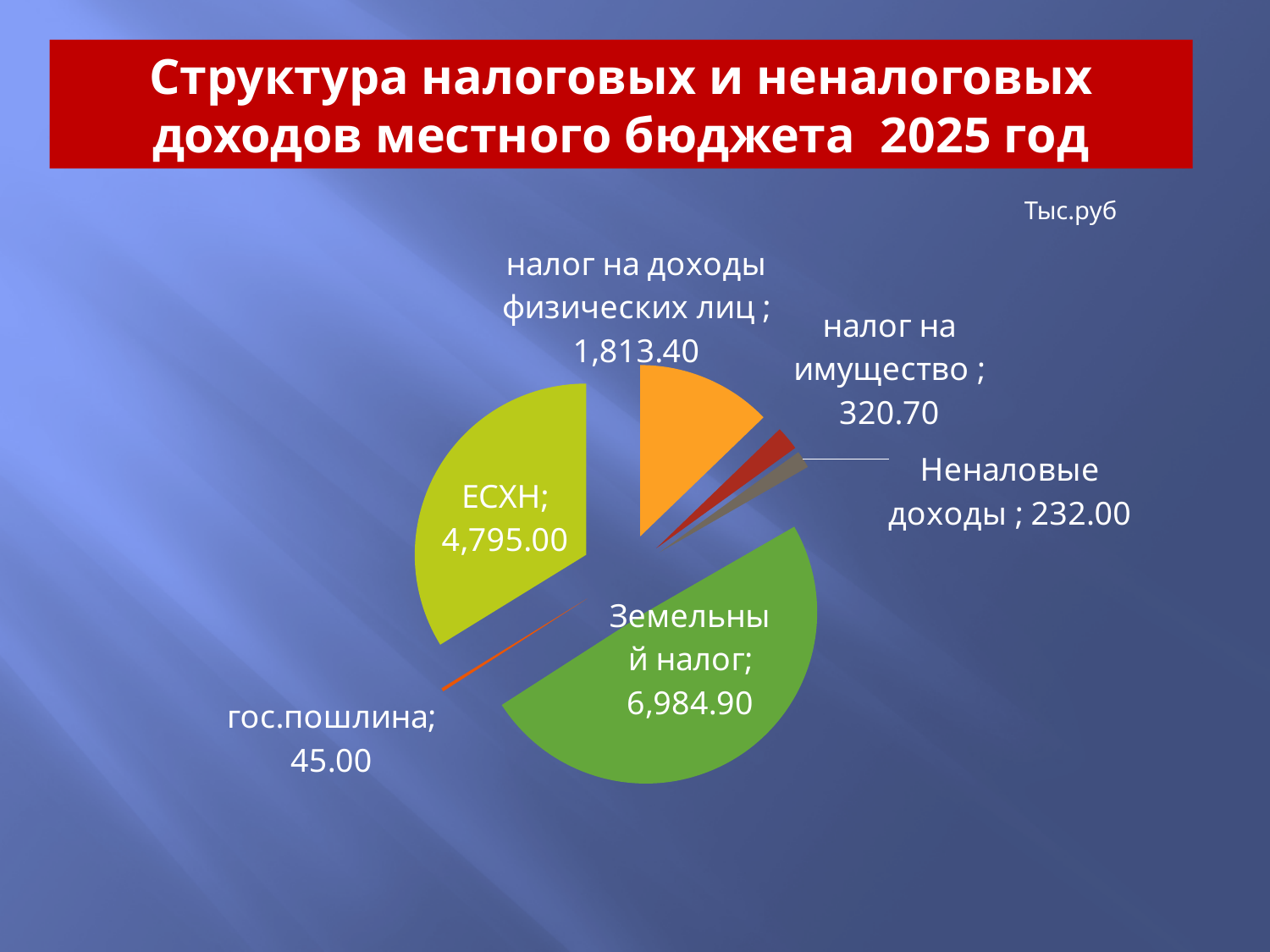
What type of chart is shown on the slide? pie chart How many slices does the pie chart have? 6 What is the value for гос.пошлина? 45.00 What is the difference between Земельный налог and ЕСХН? 2,189.90 Which is larger, налог на имущество or Неналовые доходы? налог на имущество What is the value for Земельный налог? 6,984.90 What is the value for налог на доходы физических лиц? 1,813.40 What is the value for ЕСХН? 4,795.00 Which category has the smallest slice of the pie? гос.пошлина What is the value for Неналовые доходы? 232.00 What unit is indicated for the chart values? Тыс.руб Which category has the largest slice of the pie? Земельный налог